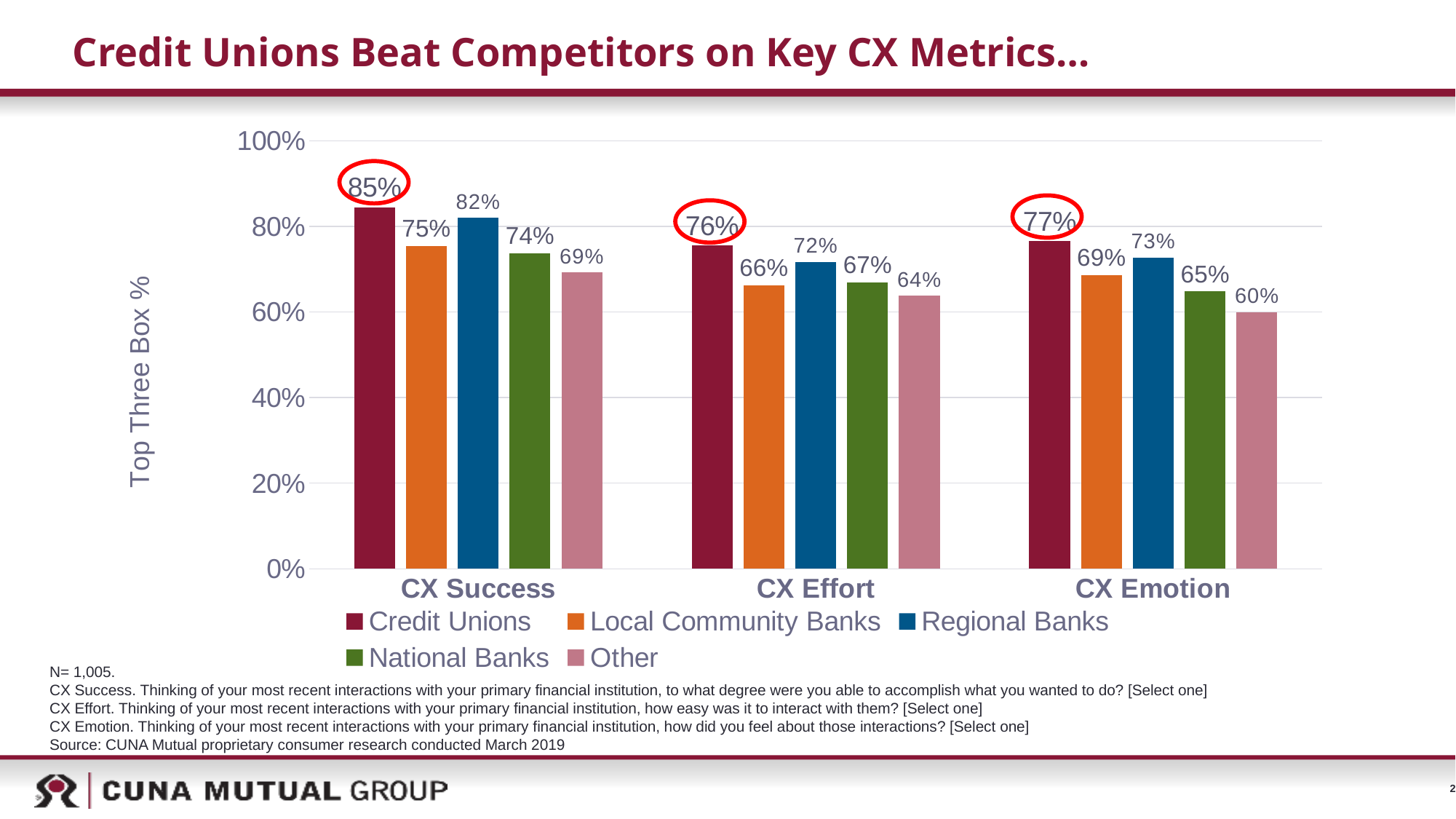
What is the difference between Credit Unions and Local Community Banks on CX Success? 10% How many categories are shown on the x axis? 3 How many series does the legend list? 5 What is the value for Regional Banks on CX Effort? 72% What is the value for Other on CX Emotion? 60% What kind of chart is shown on the slide? Bar chart Which series has the highest value on CX Emotion? Credit Unions Which is larger on CX Effort: Regional Banks or National Banks? Regional Banks What is the value for Credit Unions on CX Success? 85% What is the value for National Banks on CX Success? 74% Which series has the lowest value on CX Effort? Other What is the label on the vertical axis? Top Three Box %